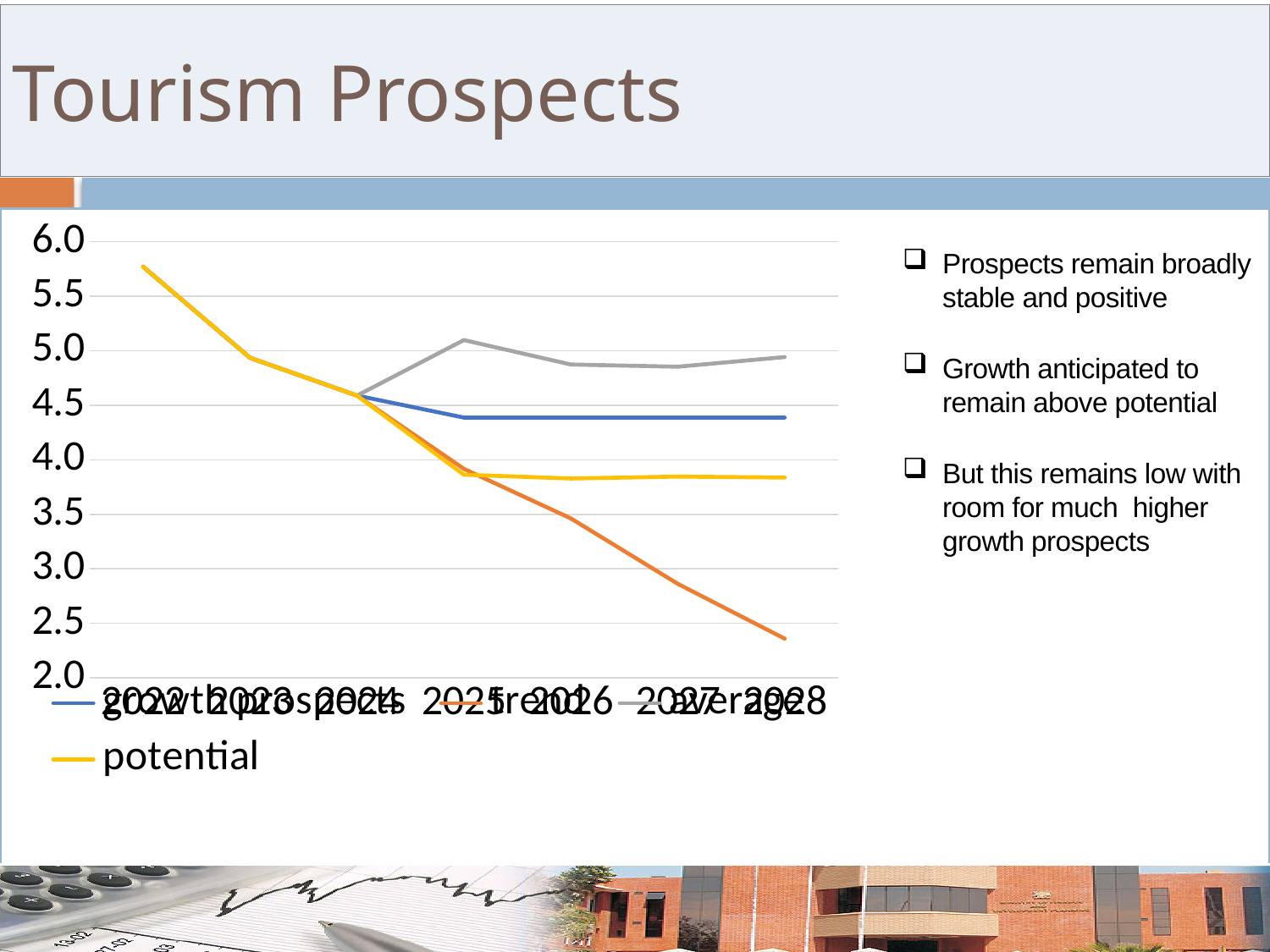
What is the title of the slide containing the chart? Tourism Prospects Is the value of the potential series in 2022 greater or less than 5.5? greater How many series does the chart legend list? 4 How many years are shown along the x axis of the chart? 7 Is the value of the trend series in 2028 greater or less than 2.5? less What kind of chart is shown on the slide? line chart Is the value of the average series in 2025 greater or less than 5.0? greater Which series has the lowest value in 2028? trend Does the potential series rise or fall from 2022 to 2025? fall In 2028, which is larger: the average series or the trend series? average Does the trend series rise or fall from 2024 to 2028? fall